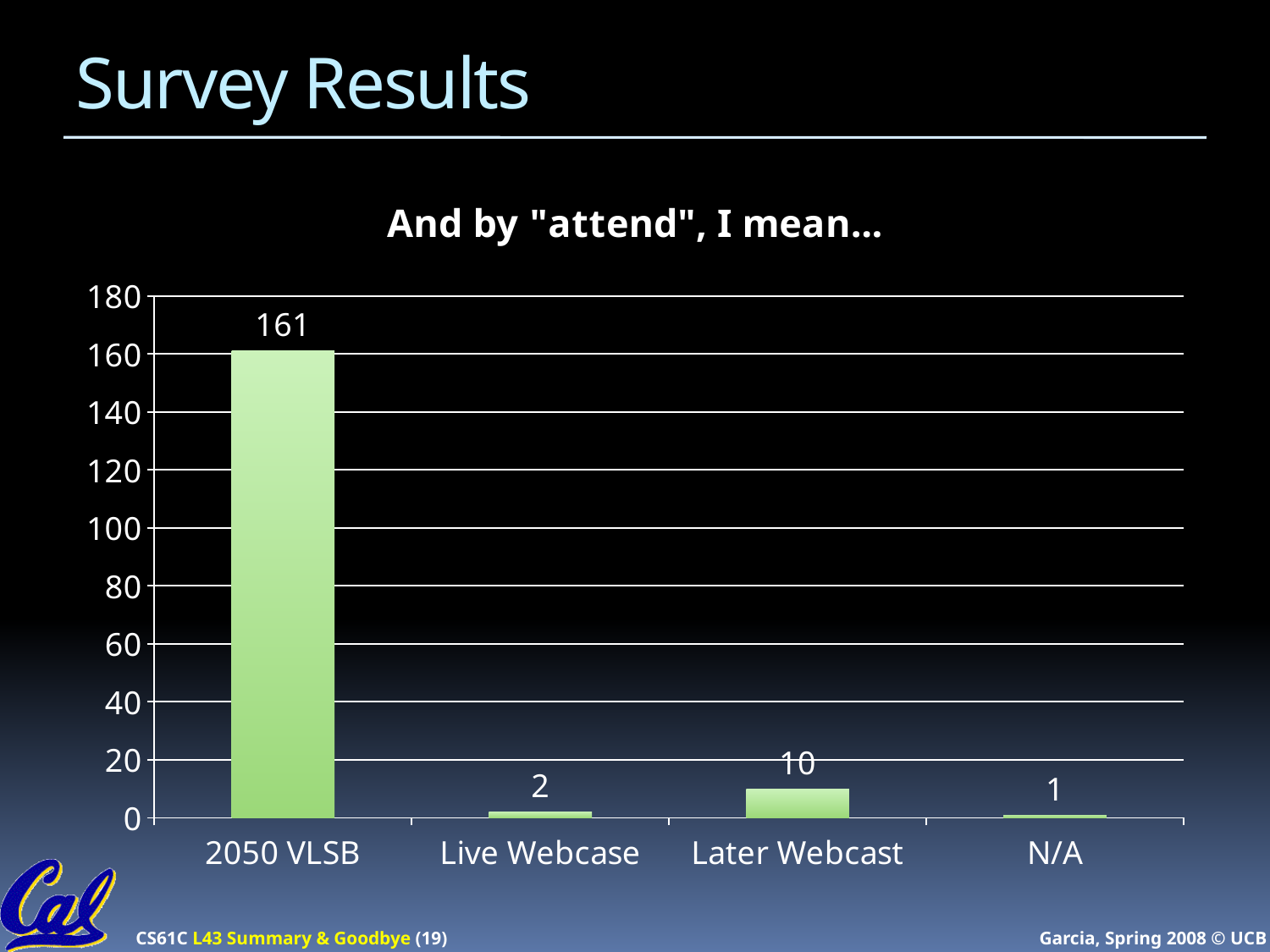
Is the value for 2050 VLSB greater or less than 140? greater Which is larger, the value for Later Webcast or the value for Live Webcase? Later Webcast What is the difference between the values for 2050 VLSB and Later Webcast? 151 Which category has the highest value? 2050 VLSB What is the title of the chart? And by "attend", I mean... What is the value for 2050 VLSB? 161 What is the value for Later Webcast? 10 How many categories are shown on the x axis? 4 What is the value for N/A? 1 What kind of chart is shown on the slide? bar chart Which category has the lowest value? N/A What is the value for Live Webcase? 2